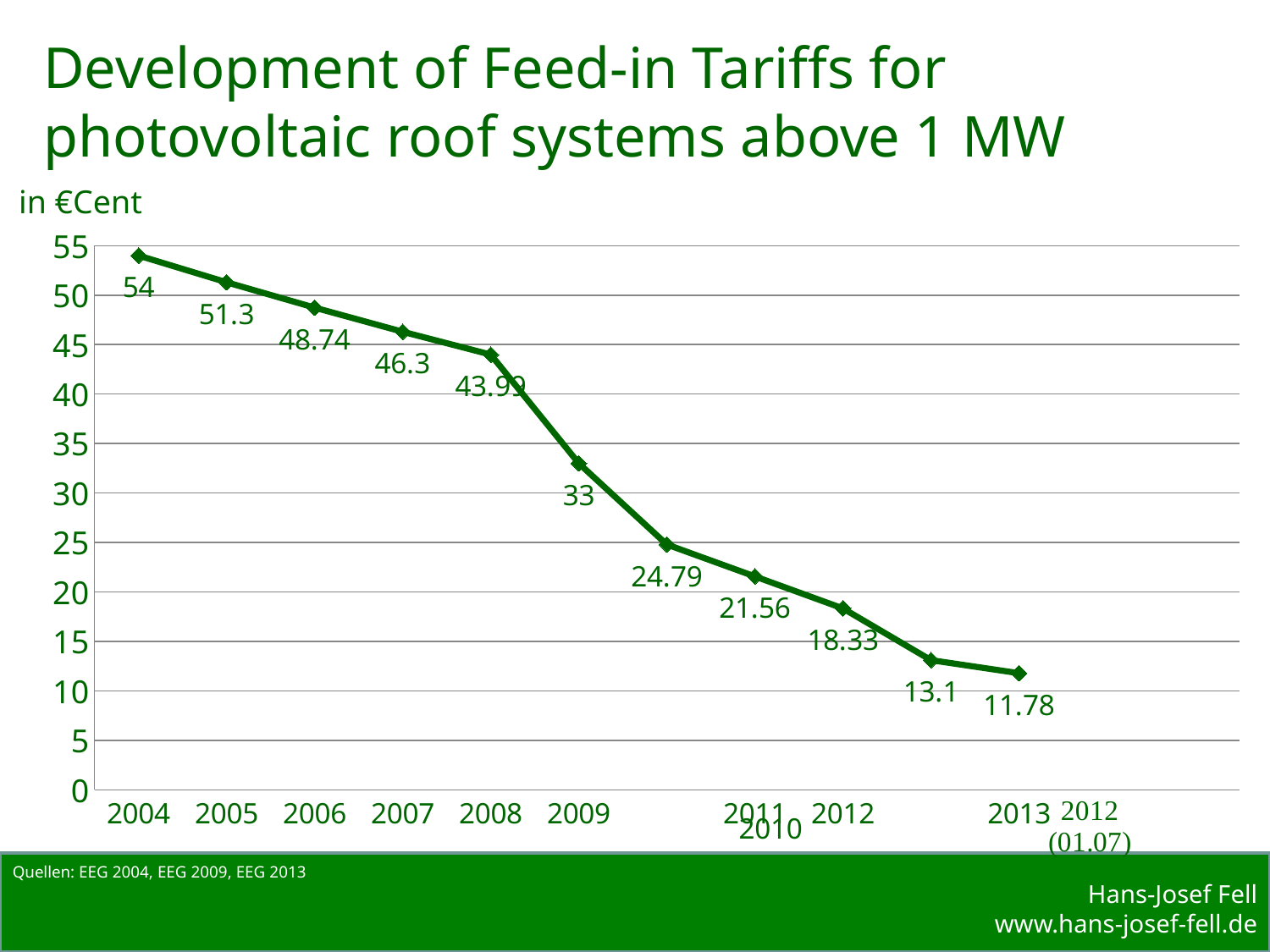
What is the feed-in tariff value plotted for 2004? 54 Is the value for 2008 greater or less than 40? greater What is the difference between the values for 2012 and 2013? 6.55 What is the value plotted for 2009? 33 What is the difference between the values for 2004 and 2005? 2.7 What is the value plotted for 2013? 11.78 What kind of chart is shown on the slide? line chart What is the lowest value plotted on the chart? 11.78 Which is larger, the value for 2007 or the value for 2011? 2007 What is the value plotted for 2006? 48.74 Which year has the highest feed-in tariff value? 2004 How many data points are plotted on the line? 11